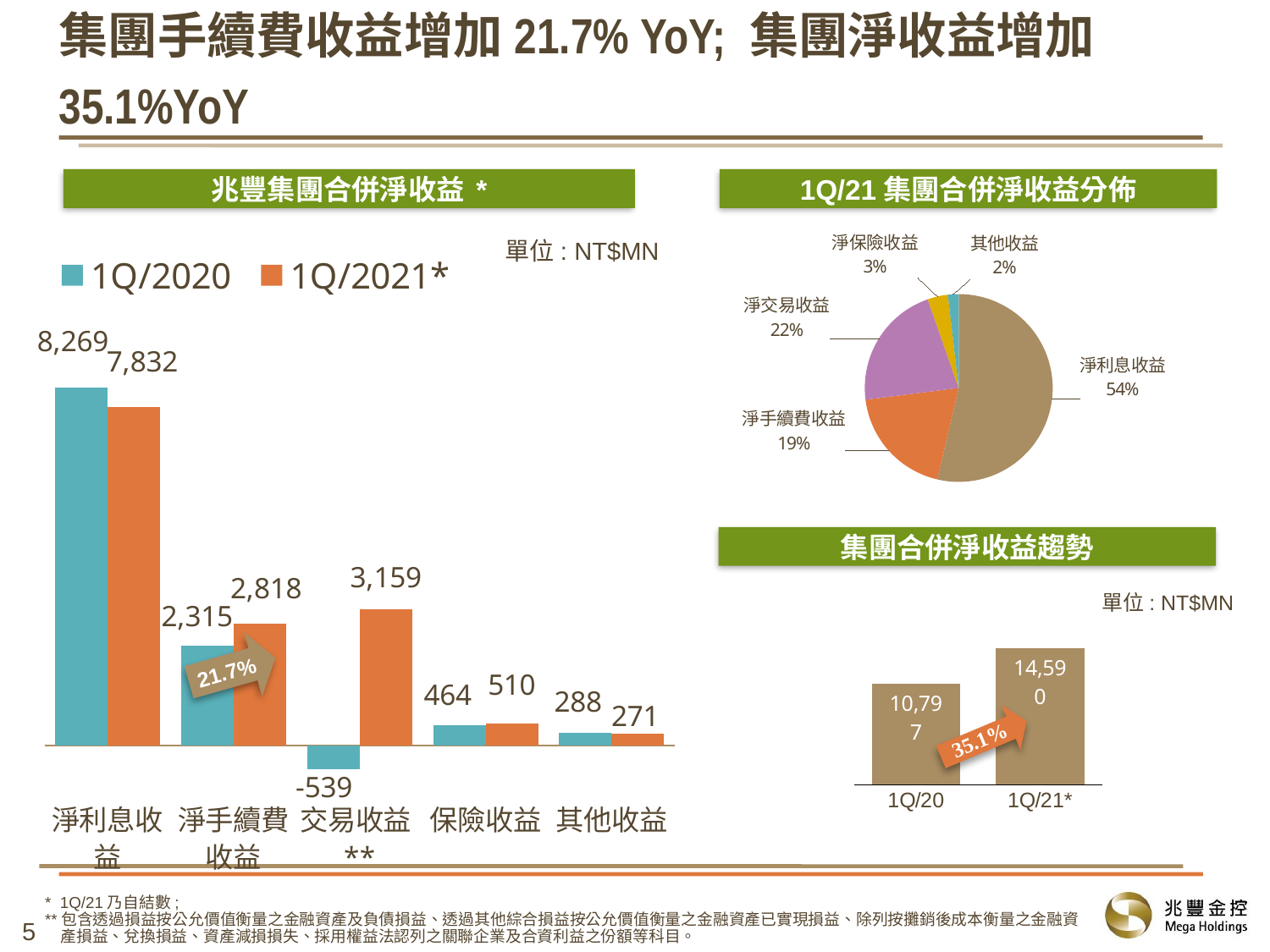
In the chart titled 兆豐集團合併淨收益 *, what is the difference between the 1Q/2020 and 1Q/2021* values for 淨利息收益? 437 In the chart titled 集團合併淨收益趨勢, what is the value for 1Q/21*? 14,590 In the chart titled 1Q/21 集團合併淨收益分佈, what share does 淨交易收益 have? 22% In the chart titled 1Q/21 集團合併淨收益分佈, which slice is the smallest? 其他收益 In the chart titled 兆豐集團合併淨收益 *, how many series does the legend list? 2 In the chart titled 兆豐集團合併淨收益 *, which category has the highest 1Q/2020 value? 淨利息收益 In the chart titled 兆豐集團合併淨收益 *, how many categories are shown on the x axis? 5 In the chart titled 兆豐集團合併淨收益 *, what is the 1Q/2020 value for 交易收益**? -539 In the chart titled 兆豐集團合併淨收益 *, which is larger for 其他收益: the 1Q/2020 value or the 1Q/2021* value? 1Q/2020 In the chart titled 集團合併淨收益趨勢, what is the difference between the 1Q/21* and 1Q/20 values? 3,793 What kind of chart is the one titled 1Q/21 集團合併淨收益分佈? pie chart In the chart titled 兆豐集團合併淨收益 *, what is the 1Q/2021* value for 淨手續費收益? 2,818